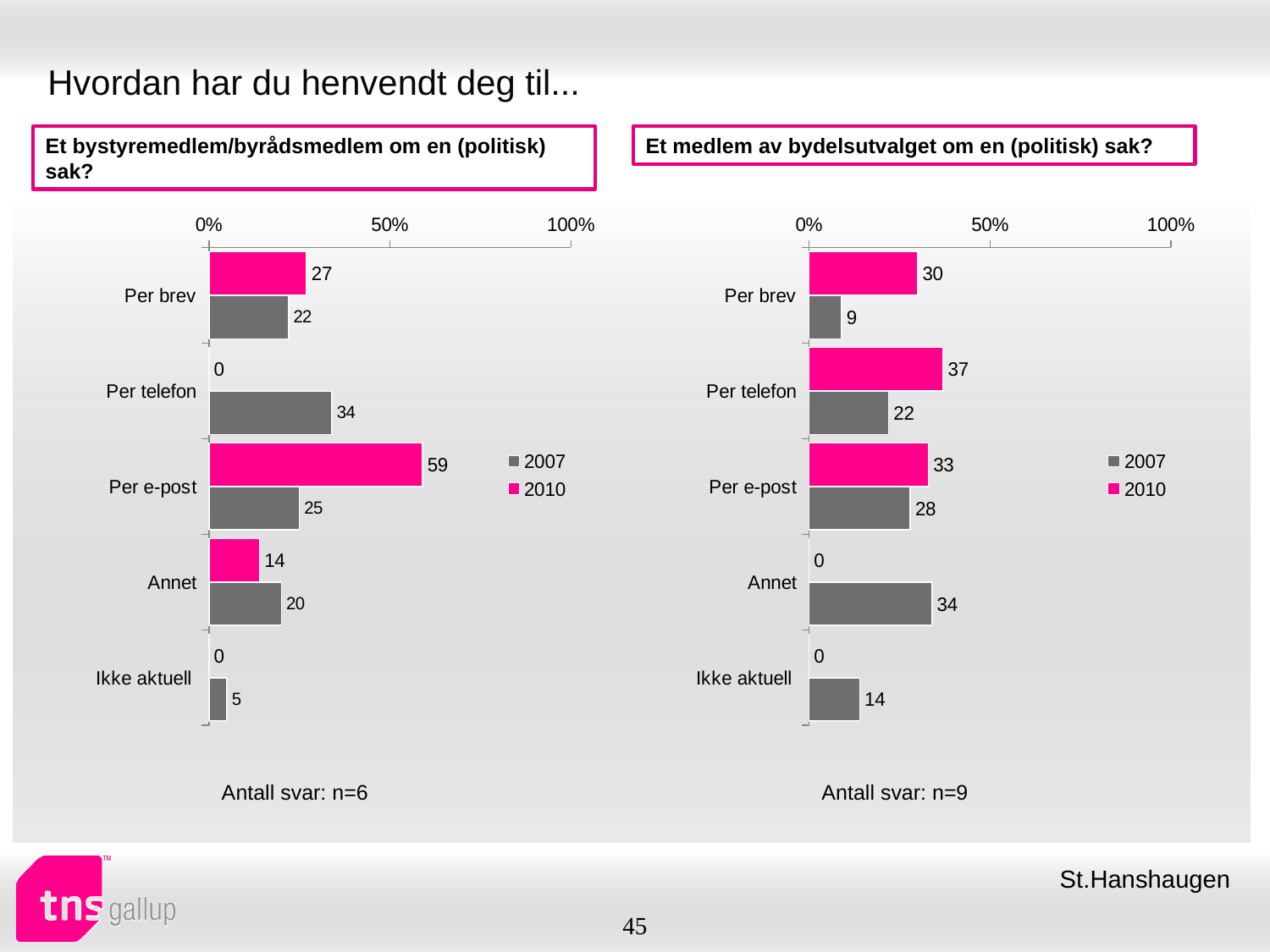
What kind of chart is the right chart (Et medlem av bydelsutvalget om en (politisk) sak?)? Bar chart In the left chart (Et bystyremedlem/byrådsmedlem om en (politisk) sak?), what is the 2010 value for Per e-post? 59 How many series does the legend of the left chart (Et bystyremedlem/byrådsmedlem om en (politisk) sak?) list? 2 In the right chart (Et medlem av bydelsutvalget om en (politisk) sak?), which is larger for Per e-post: the 2007 value or the 2010 value? 2010 In the left chart (Et bystyremedlem/byrådsmedlem om en (politisk) sak?), what is the difference between the 2010 and 2007 values for Per e-post? 34 In the left chart (Et bystyremedlem/byrådsmedlem om en (politisk) sak?), which category has the lowest 2007 value? Ikke aktuell In the right chart (Et medlem av bydelsutvalget om en (politisk) sak?), what is the 2007 value for Per brev? 9 In the left chart (Et bystyremedlem/byrådsmedlem om en (politisk) sak?), is the 2010 value for Per e-post greater or less than 50%? greater In the left chart (Et bystyremedlem/byrådsmedlem om en (politisk) sak?), what is the 2007 value for Per telefon? 34 In the right chart (Et medlem av bydelsutvalget om en (politisk) sak?), what is the difference between the 2010 and 2007 values for Per brev? 21 In the right chart (Et medlem av bydelsutvalget om en (politisk) sak?), which category has the highest 2010 value? Per telefon How many categories are shown in the right chart (Et medlem av bydelsutvalget om en (politisk) sak?)? 5